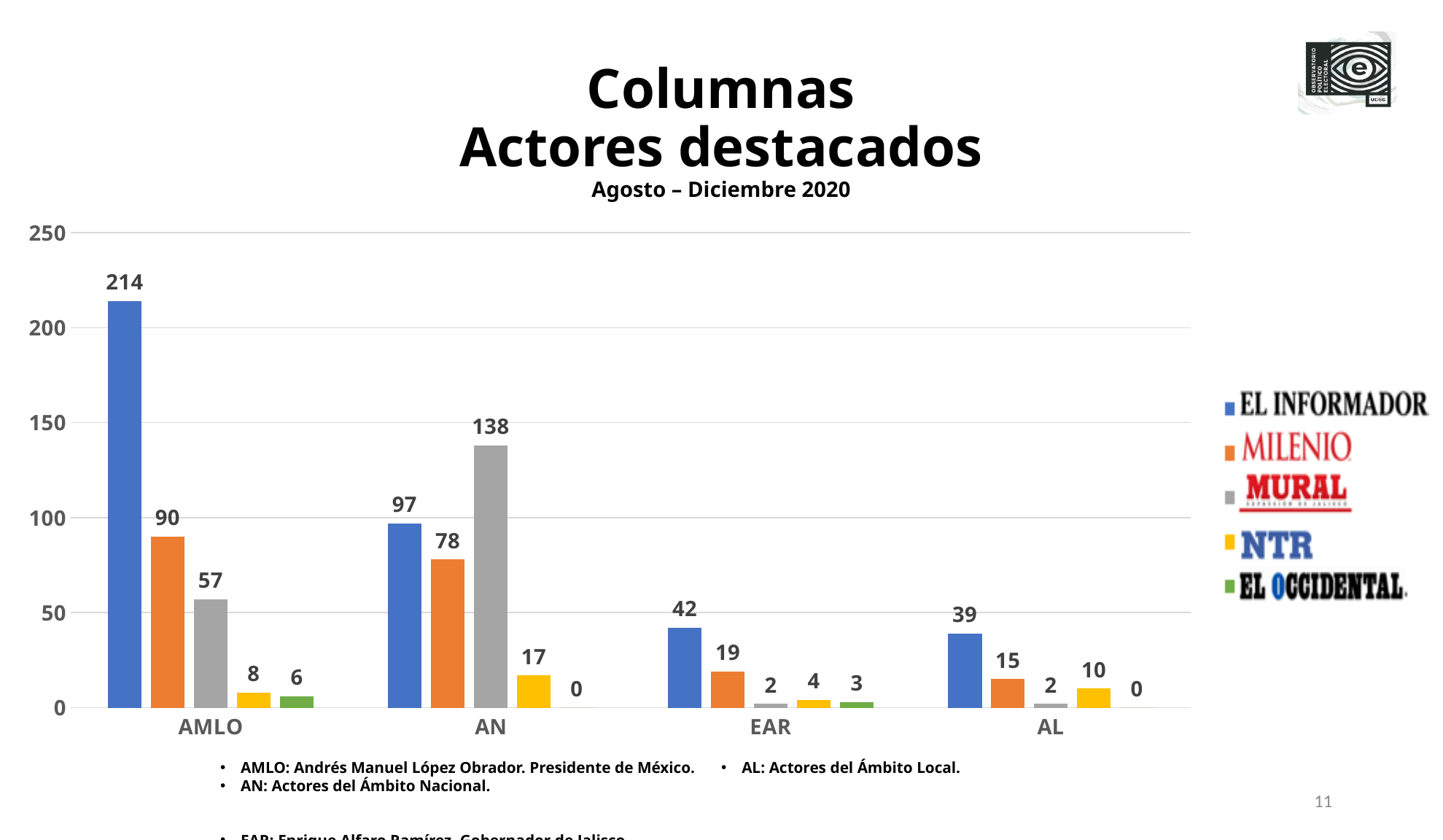
What is the value for Milenio in the EAR category? 19 What is the difference between the El Informador values for AMLO and AN? 117 Which newspaper has the highest value in the AN category? Mural What kind of chart is shown on the slide? Bar chart Which is larger: the Milenio value for AMLO or the Mural value for AN? Mural value for AN Which newspaper has the lowest value in the AMLO category? El Occidental What is the value for El Informador in the AMLO category? 214 What is the value for Mural in the AN category? 138 How many categories are shown on the x axis? 4 What is the total of the five values in the EAR category? 70 How many series does the legend list? 5 What is the value for NTR in the AL category? 10